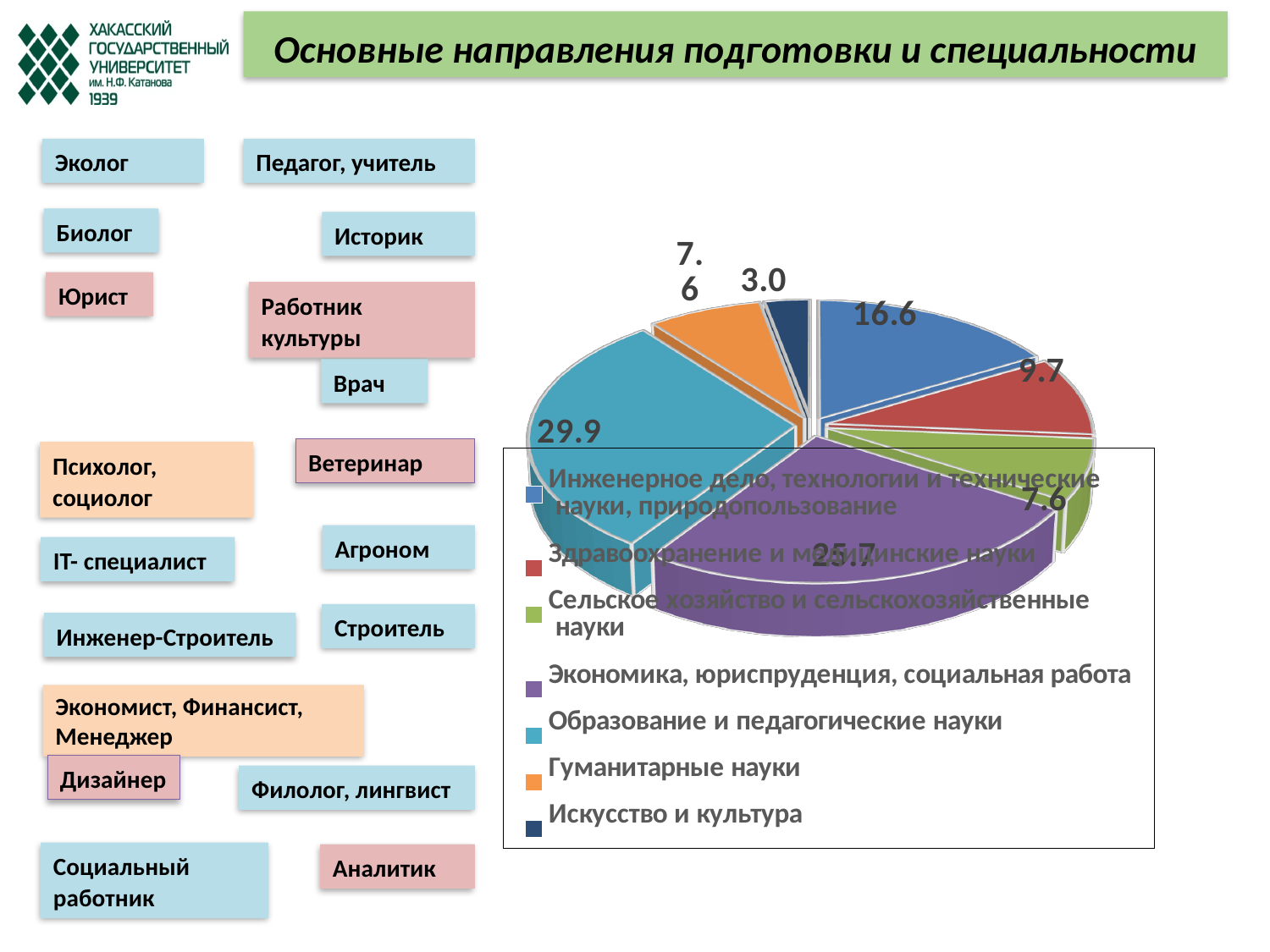
How many categories does the legend of the pie chart list? 7 What is the difference between the values for Здравоохранение и медицинские науки and Искусство и культура? 6.7 What kind of chart is shown on the slide? pie chart Which category has the largest slice of the pie? Образование и педагогические науки What value is shown for Образование и педагогические науки? 29.9 Which category has the smallest slice of the pie? Искусство и культура What value is shown for Искусство и культура? 3.0 What colour is the slice for Гуманитарные науки? orange What value is shown for Здравоохранение и медицинские науки? 9.7 Which is larger: Инженерное дело, технологии и технические науки, природопользование or Здравоохранение и медицинские науки? Инженерное дело, технологии и технические науки, природопользование What value is shown for Инженерное дело, технологии и технические науки, природопользование? 16.6 What is the difference between the values for Образование и педагогические науки and Инженерное дело, технологии и технические науки, природопользование? 13.3